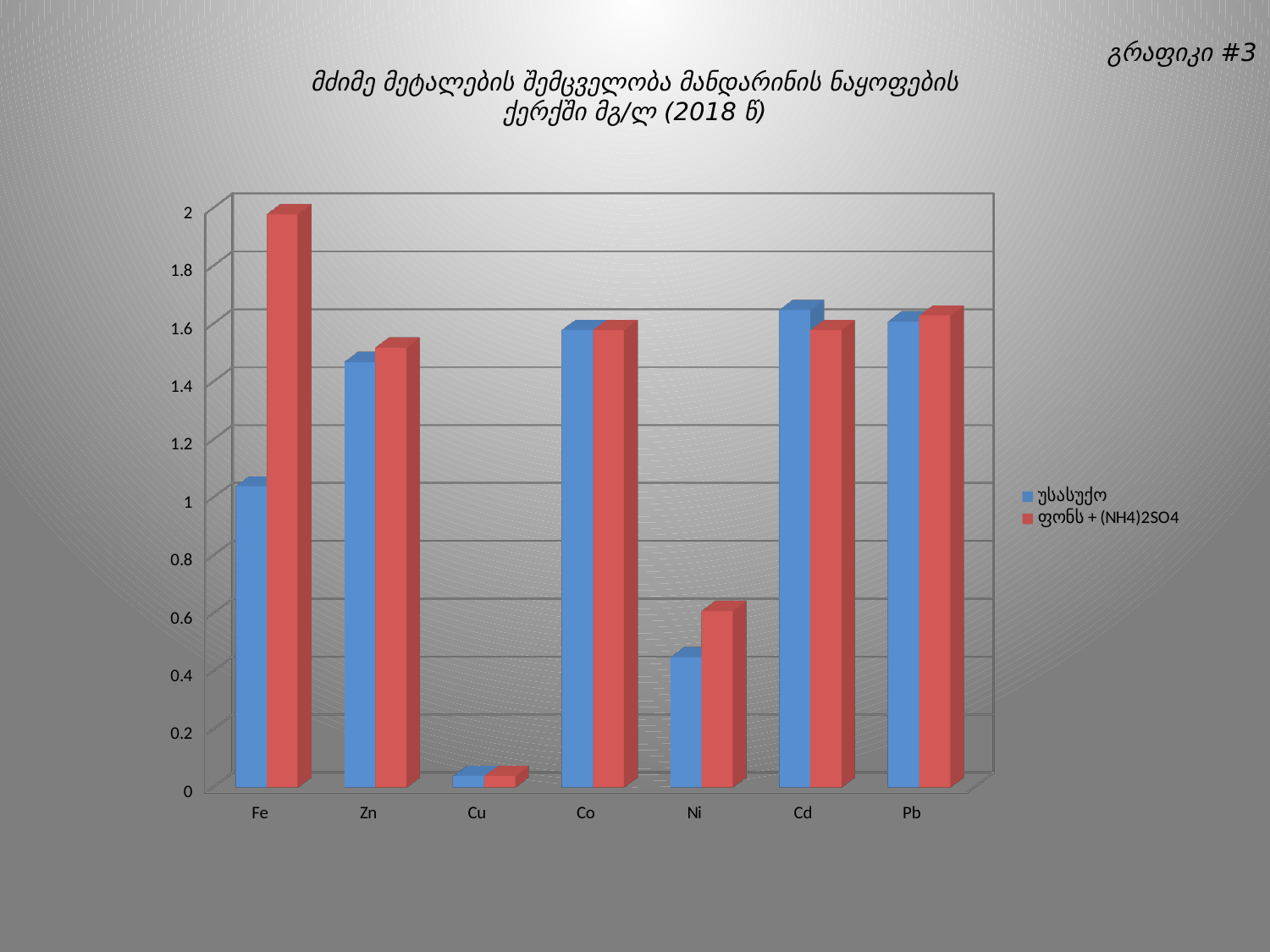
For Fe, which series has the larger value: უსასუქო or ფონს + (NH4)2SO4? ფონს + (NH4)2SO4 How many series does the chart's legend list? 2 Is the value for Cu in the უსასუქო series greater or less than 0.2? less Is the value for Ni in the უსასუქო series greater or less than 0.6? less What kind of chart is shown on the slide? bar chart In the უსასუქო series, which is larger: the value for Fe or the value for Zn? Zn Which colour represents the უსასუქო series in the chart? blue Is the value for Fe in the ფონს + (NH4)2SO4 series greater or less than 1.8? greater Which category has the highest value for the ფონს + (NH4)2SO4 series? Fe Which category has the lowest value for the უსასუქო series? Cu How many categories are shown on the x axis of the chart? 7